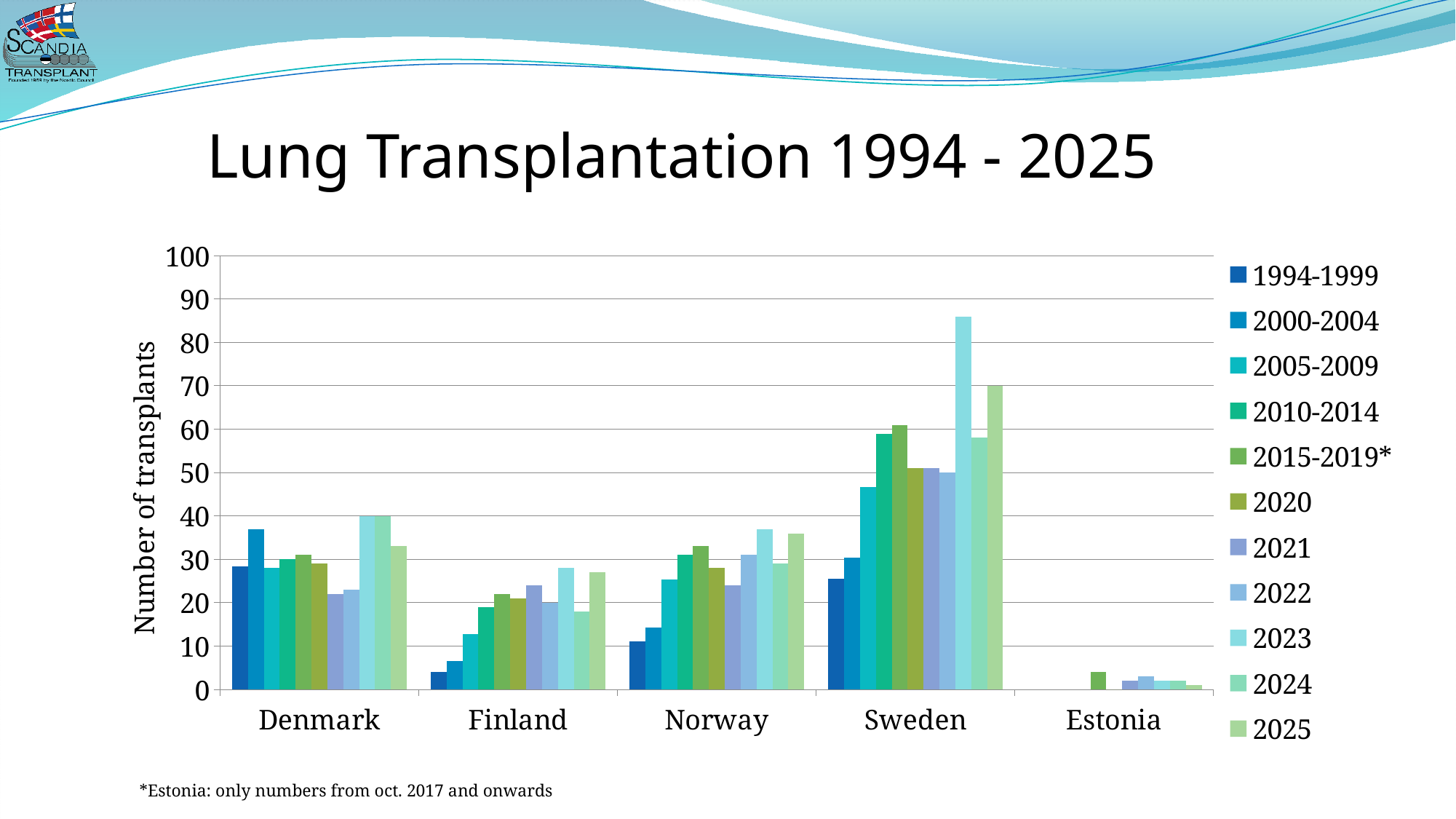
How many countries are shown on the x axis? 5 Which country has the highest bar in the chart? Sweden How many series does the legend list? 11 What is the title of the chart? Lung Transplantation 1994 - 2025 Is the value for Finland in 1994-1999 greater or less than 10? less Is the value for Sweden in 2025 greater or less than 60? greater What is the label on the vertical axis? Number of transplants What kind of chart is shown on the slide? bar chart Is the value for Sweden in 2023 greater or less than 80? greater Which country has the lowest bars overall? Estonia For Sweden, which period has the highest bar? 2023 Which is larger for Finland: the 2023 bar or the 2024 bar? 2023